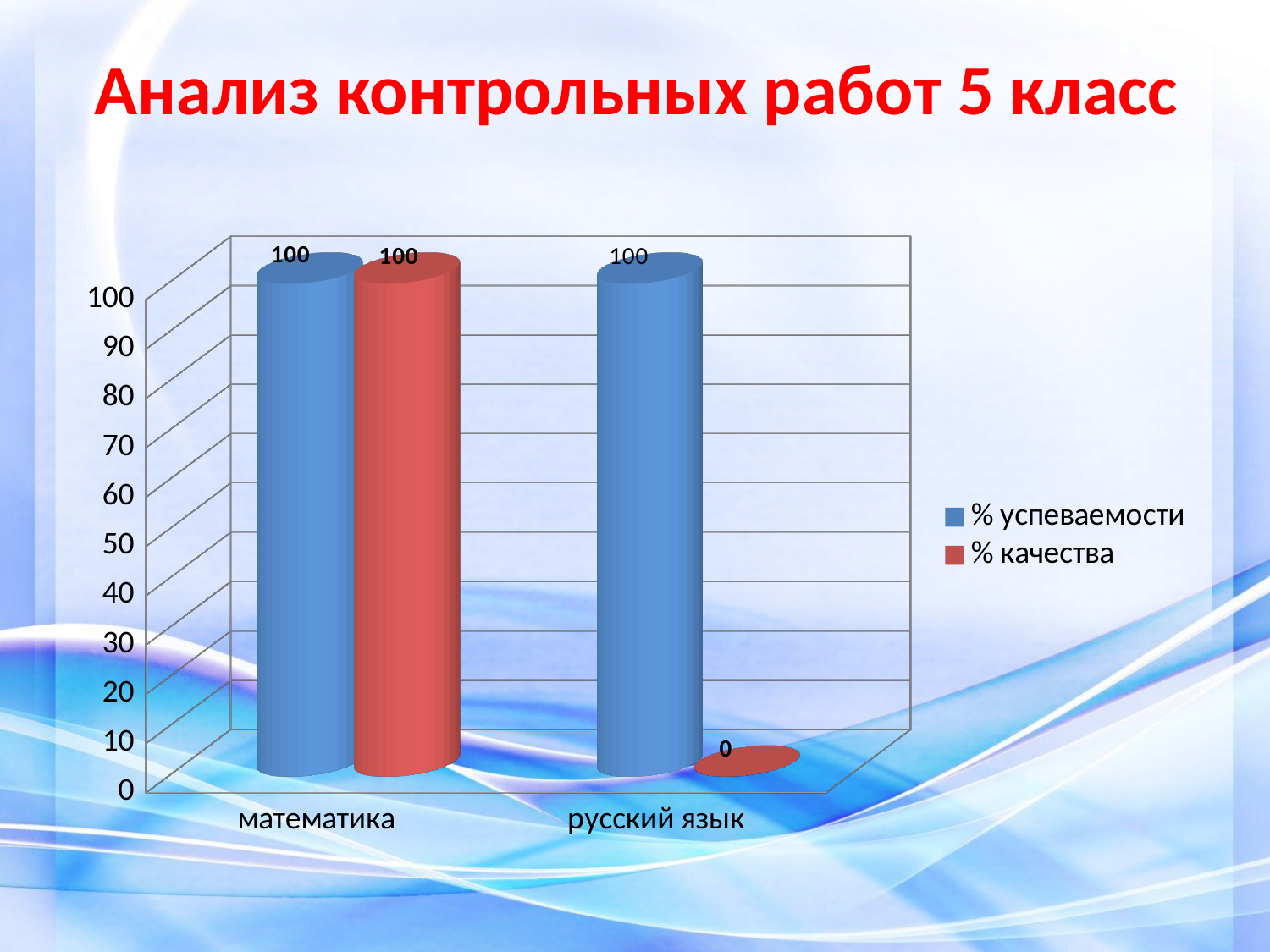
Which is larger: % качества for математика or % качества for русский язык? математика What is the value of % успеваемости for русский язык? 100 Is the value of % качества for русский язык greater or less than 50? less What is the difference between % качества for математика and % качества for русский язык? 100 What is the title of the slide? Анализ контрольных работ 5 класс Which category has the lowest value for % качества? русский язык What is the value of % качества for математика? 100 How many series does the legend list? 2 What is the value of % успеваемости for математика? 100 What is the value of % качества for русский язык? 0 How many categories are shown on the x axis? 2 What kind of chart is shown on the slide? bar chart